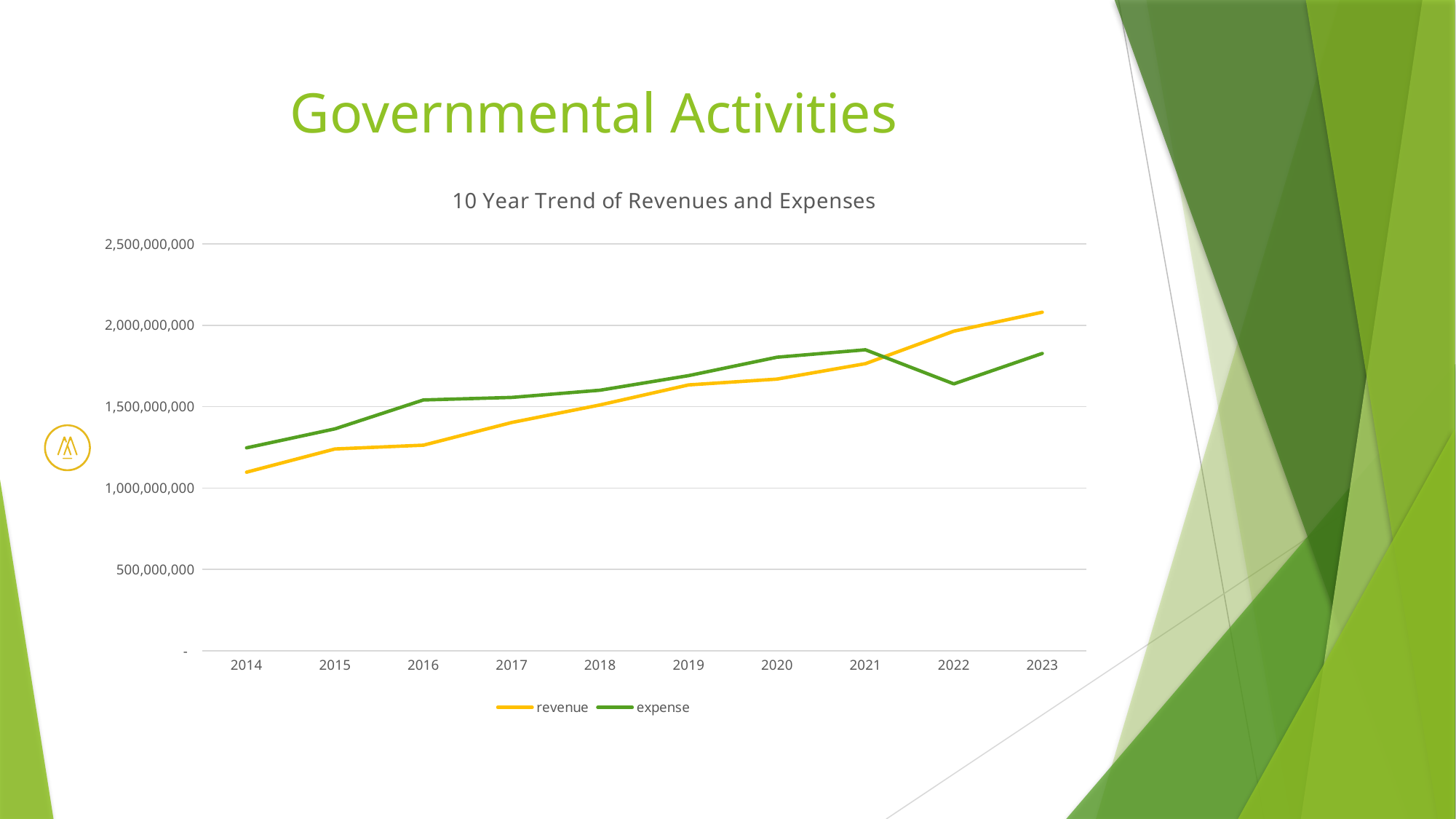
In 2014, which is larger, revenue or expense? expense What is the title of the chart? 10 Year Trend of Revenues and Expenses Does the revenue line generally rise or fall from 2014 to 2023? rise Is the revenue value for 2023 greater or less than 2,000,000,000? greater What kind of chart is shown on the slide? line chart Which colour is used for the revenue line? yellow Is the expense value for 2023 greater or less than 2,000,000,000? less Does the expense line rise or fall from 2021 to 2022? fall Is the revenue value for 2014 greater or less than 1,500,000,000? less How many years are plotted along the x axis? 10 How many series does the legend list? 2 In 2023, which is larger, revenue or expense? revenue